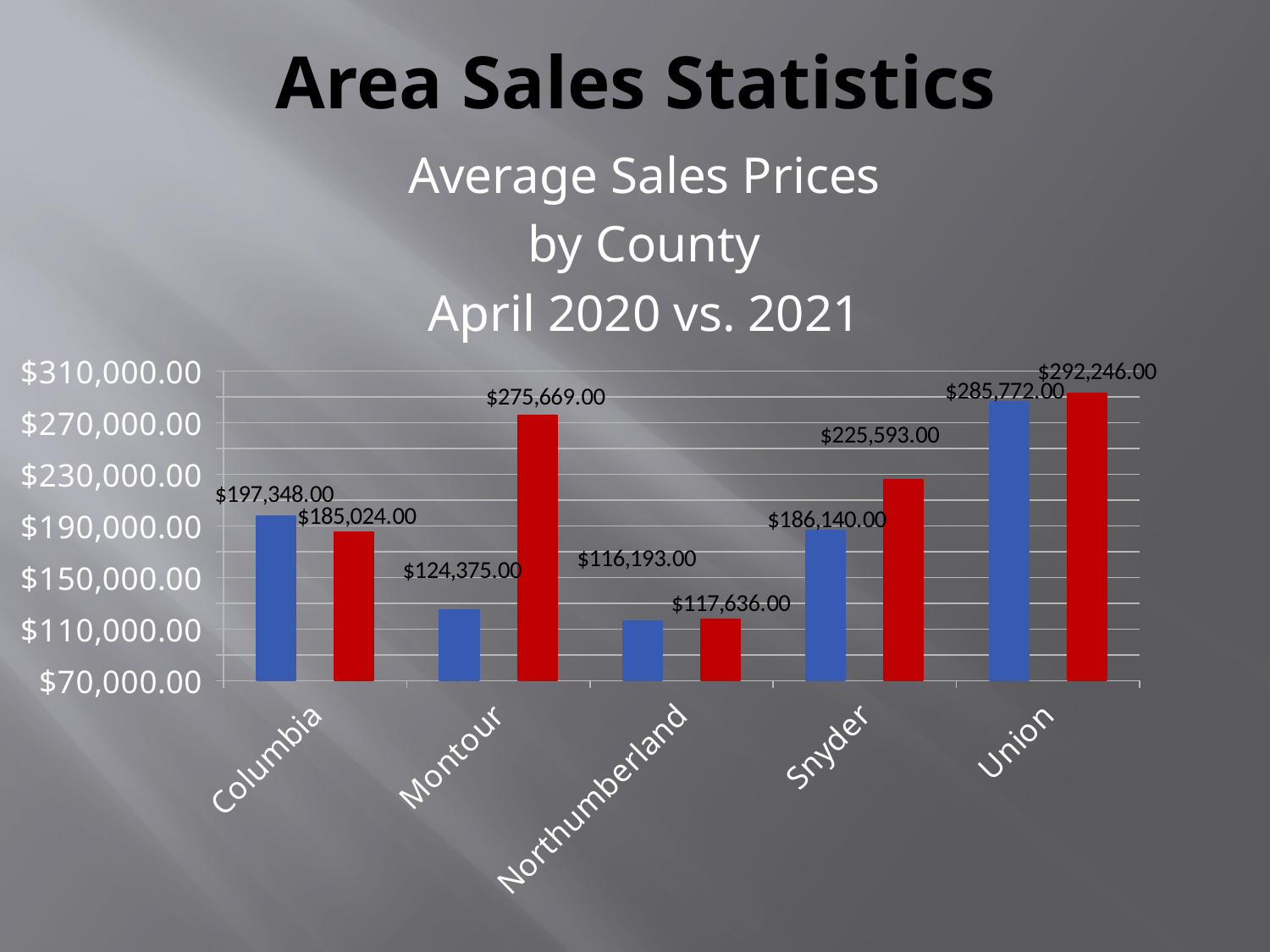
What is the value of the blue bar for Columbia? $197,348.00 What kind of chart is shown on the slide? Bar chart Is the value of the red bar for Snyder greater or less than $190,000.00? greater Which county has the highest red bar? Union What is the difference between the red bar and the blue bar for Montour? $151,294.00 What is the value of the red bar for Union? $292,246.00 What is the title of the chart? Average Sales Prices by County April 2020 vs. 2021 How many counties are shown on the x axis? 5 Which county has the lowest blue bar? Northumberland What is the value of the red bar for Montour? $275,669.00 For Columbia, which is larger, the blue bar or the red bar? The blue bar What is the value of the blue bar for Snyder? $186,140.00